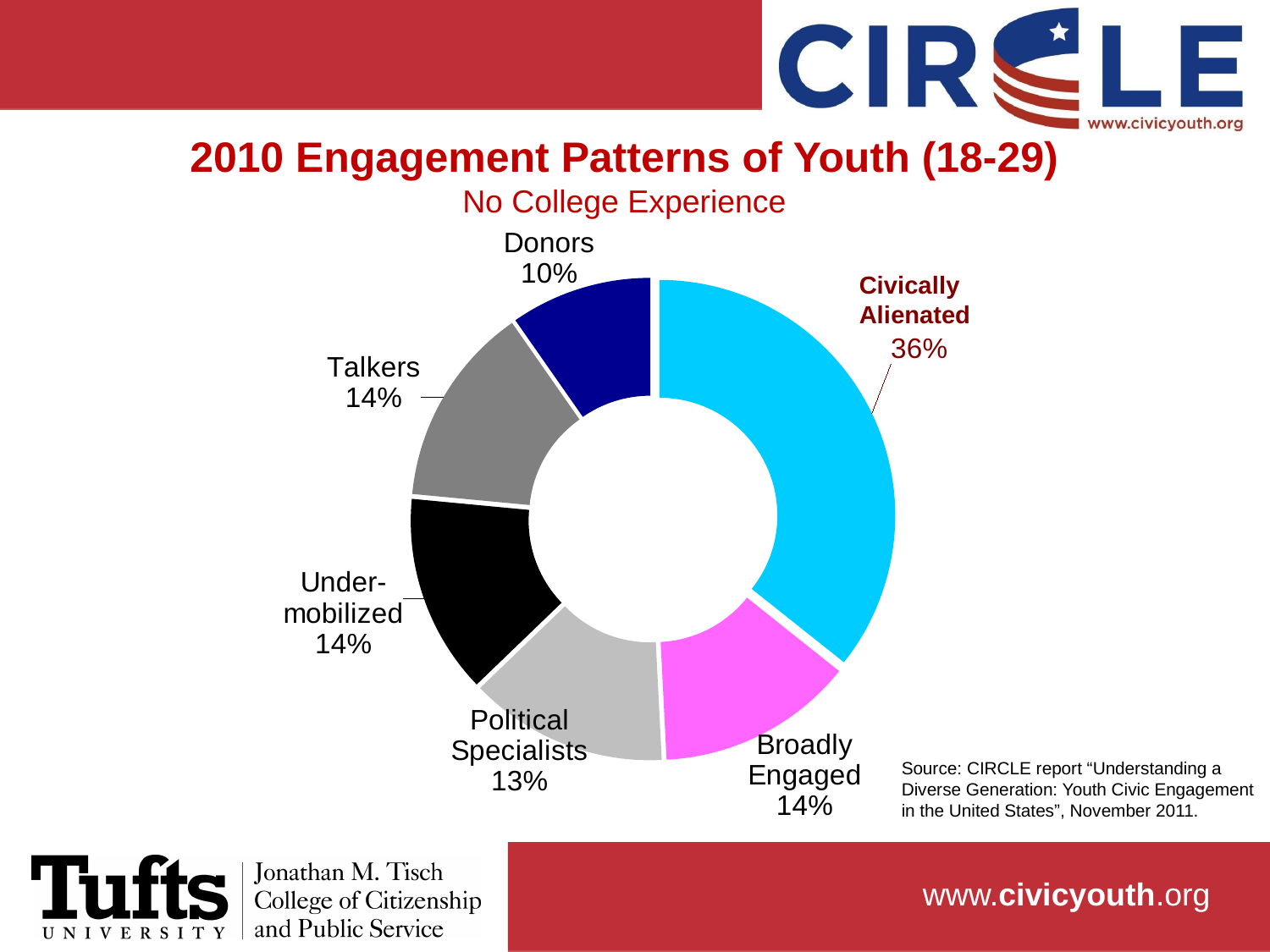
What is the subtitle shown above the chart? No College Experience What is the difference in percentage points between Civically Alienated and Broadly Engaged? 22 What is the difference in percentage points between Political Specialists and Donors? 3 What percentage is shown for Political Specialists? 13% What percentage of youth with no college experience are Civically Alienated? 36% Which category has the smallest share of the chart? Donors What share of the chart is labelled Donors? 10% What percentage is shown for Talkers? 14% What kind of chart is shown on the slide? Pie chart (doughnut) Which category has the largest share of the chart? Civically Alienated Which is larger, the share for Under-mobilized or the share for Political Specialists? Under-mobilized How many categories are shown in the chart? 6